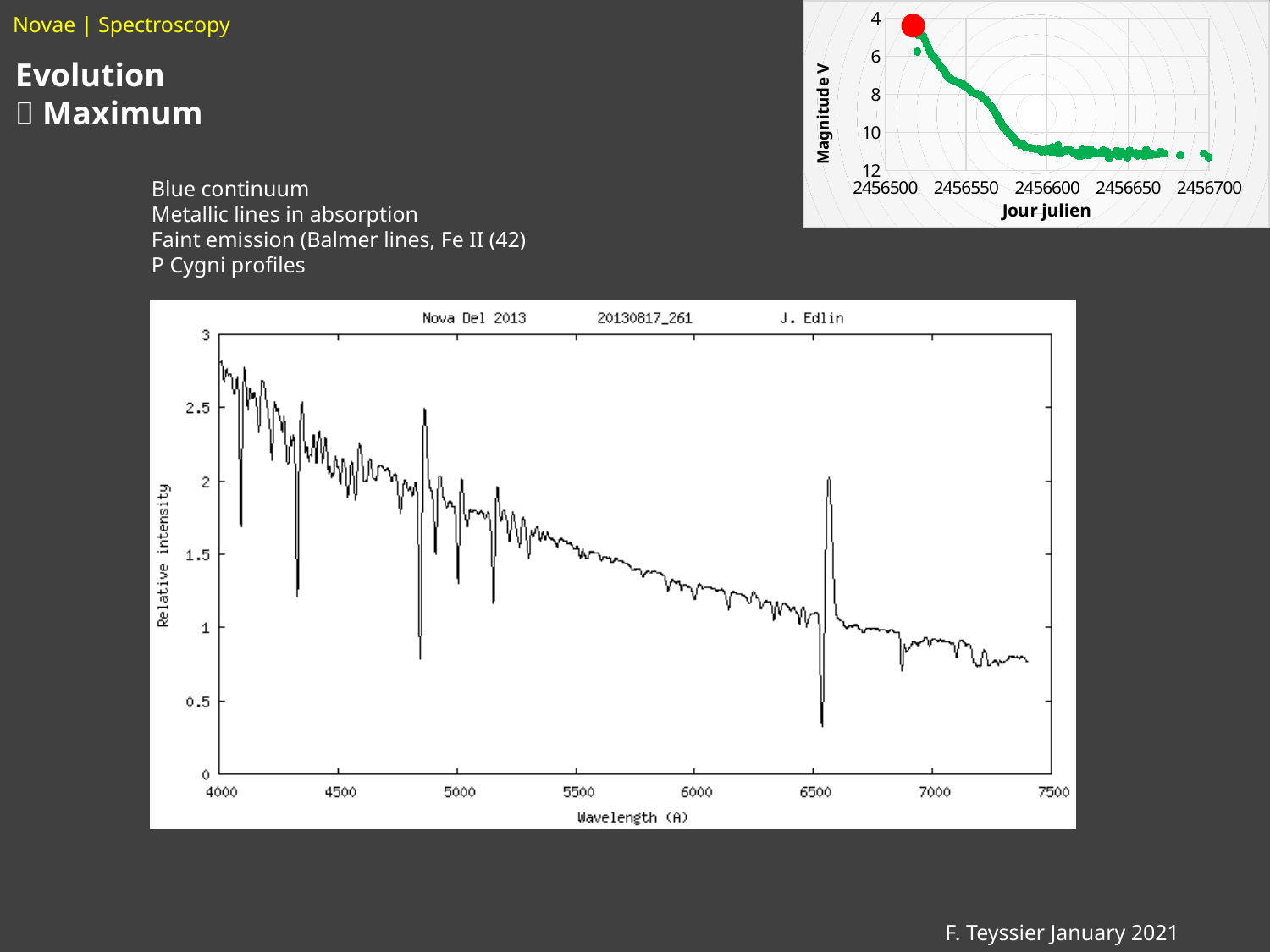
In the top-right light curve chart, is the Magnitude V value of the red point greater or less than 6? less What kind of chart is the bottom chart titled 'Nova Del 2013'? line chart In the bottom spectrum chart, does the relative intensity generally rise or fall as wavelength increases from 4000 to 7500? fall What is the x-axis label of the bottom spectrum chart? Wavelength (A) In the bottom spectrum chart, is the relative intensity at wavelength 7000 greater or less than 1? less In the bottom spectrum chart, is the relative intensity at wavelength 6000 greater or less than 1.5? less What is the x-axis label of the top-right light curve chart? Jour julien What kind of chart is the top-right chart with 'Magnitude V' on the y axis? scatter chart In the top-right light curve chart, does the Magnitude V value rise or fall as Jour julien increases? rise